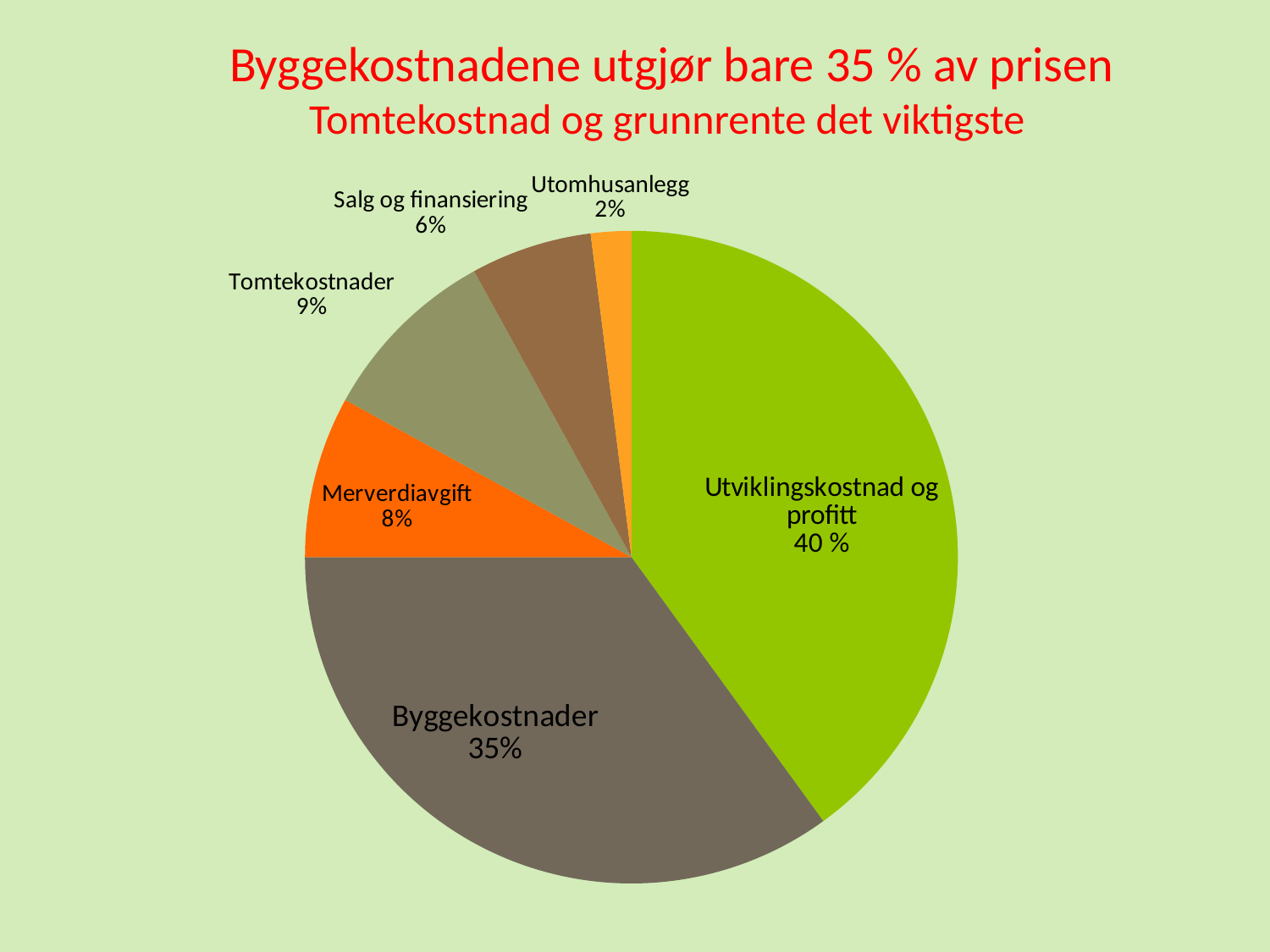
What is the value shown for Tomtekostnader? 9% What share of the pie does Byggekostnader represent? 35% What is the value shown for Utomhusanlegg? 2% Which slice of the pie is the largest? Utviklingskostnad og profitt How many slices does the pie chart have? 6 Which slice of the pie is the smallest? Utomhusanlegg What share of the pie does Utviklingskostnad og profitt represent? 40 % What kind of chart is shown on the slide? pie chart What is the value shown for Merverdiavgift? 8% What is the value shown for Salg og finansiering? 6% Which is larger, the share for Tomtekostnader or the share for Merverdiavgift? Tomtekostnader What is the difference between the shares of Utviklingskostnad og profitt and Byggekostnader? 5 percentage points